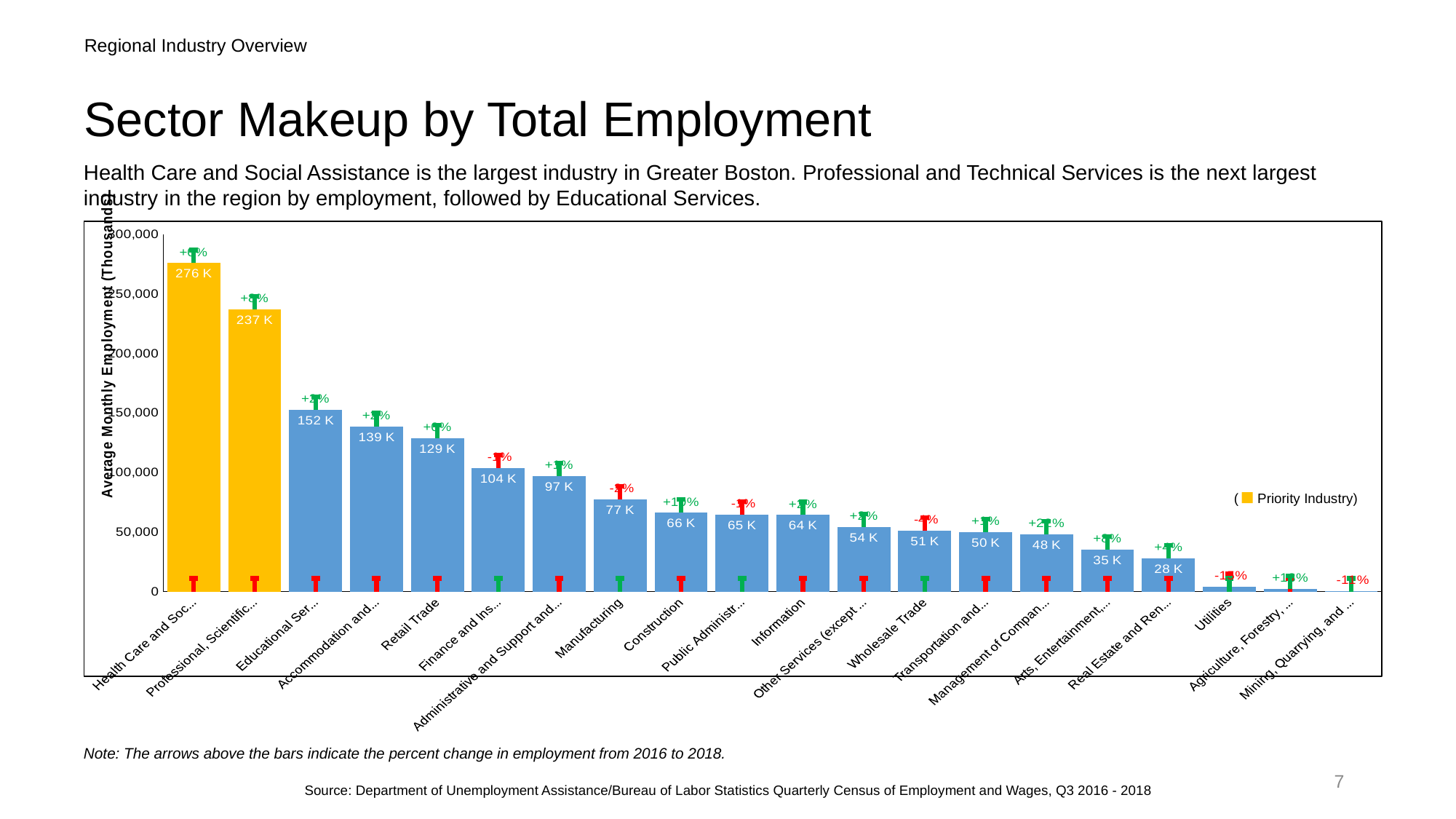
What kind of chart is shown on the slide? bar chart What is the value for Wholesale Trade? 51 K What is the difference between the two highest bars, Health Care and Soc... and Professional, Scientific...? 39 K What is the difference between the values for Retail Trade and Manufacturing? 52 K How many categories are shown on the x axis? 20 What is the value for Manufacturing? 77 K What is the value for Information? 64 K Which is larger, the value for Construction or the value for Wholesale Trade? Construction What is the value for Retail Trade? 129 K Do the bar values rise or fall from left to right along the x axis? fall Which category has the highest value? Health Care and Soc... Is the value for Utilities greater or less than 50,000? less